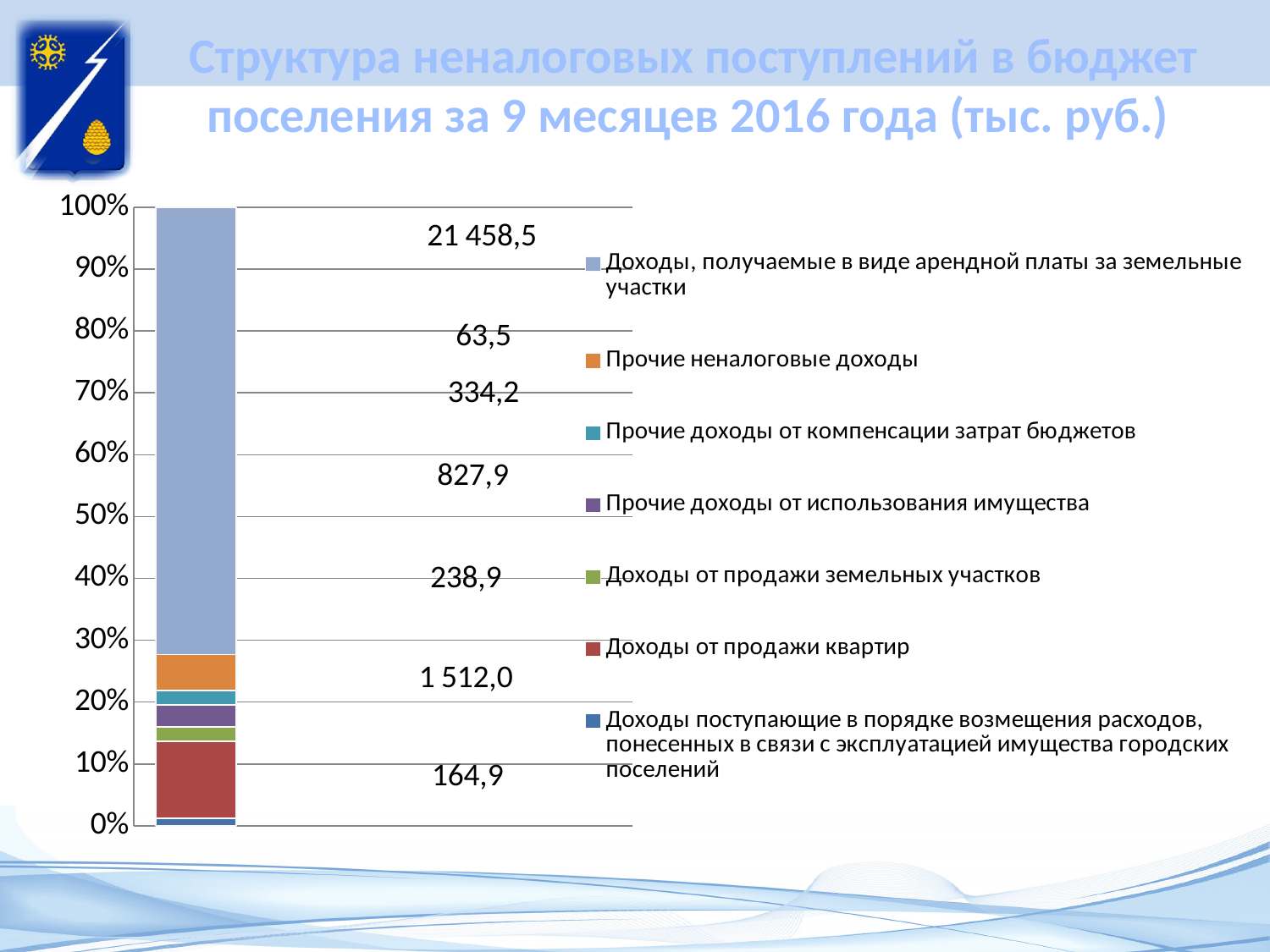
Which legend entry is shown in orange? Прочие неналоговые доходы What is the highest tick shown on the vertical axis? 100% What value is labelled for 'Доходы от продажи квартир'? 1 512,0 What is the largest value labelled on the chart? 21 458,5 How many series does the legend list? 7 What kind of chart is shown on the slide? Stacked bar chart What value is labelled for 'Доходы, получаемые в виде арендной платы за земельные участки'? 21 458,5 What is the smallest value labelled on the chart? 63,5 What is the difference between the values 1 512,0 and 238,9? 1 273,1 Which is larger, the value 827,9 or the value 334,2? 827,9 How many bars are plotted in the chart? 1 What value is labelled for 'Доходы поступающие в порядке возмещения расходов, понесенных в связи с эксплуатацией имущества городских поселений'? 164,9